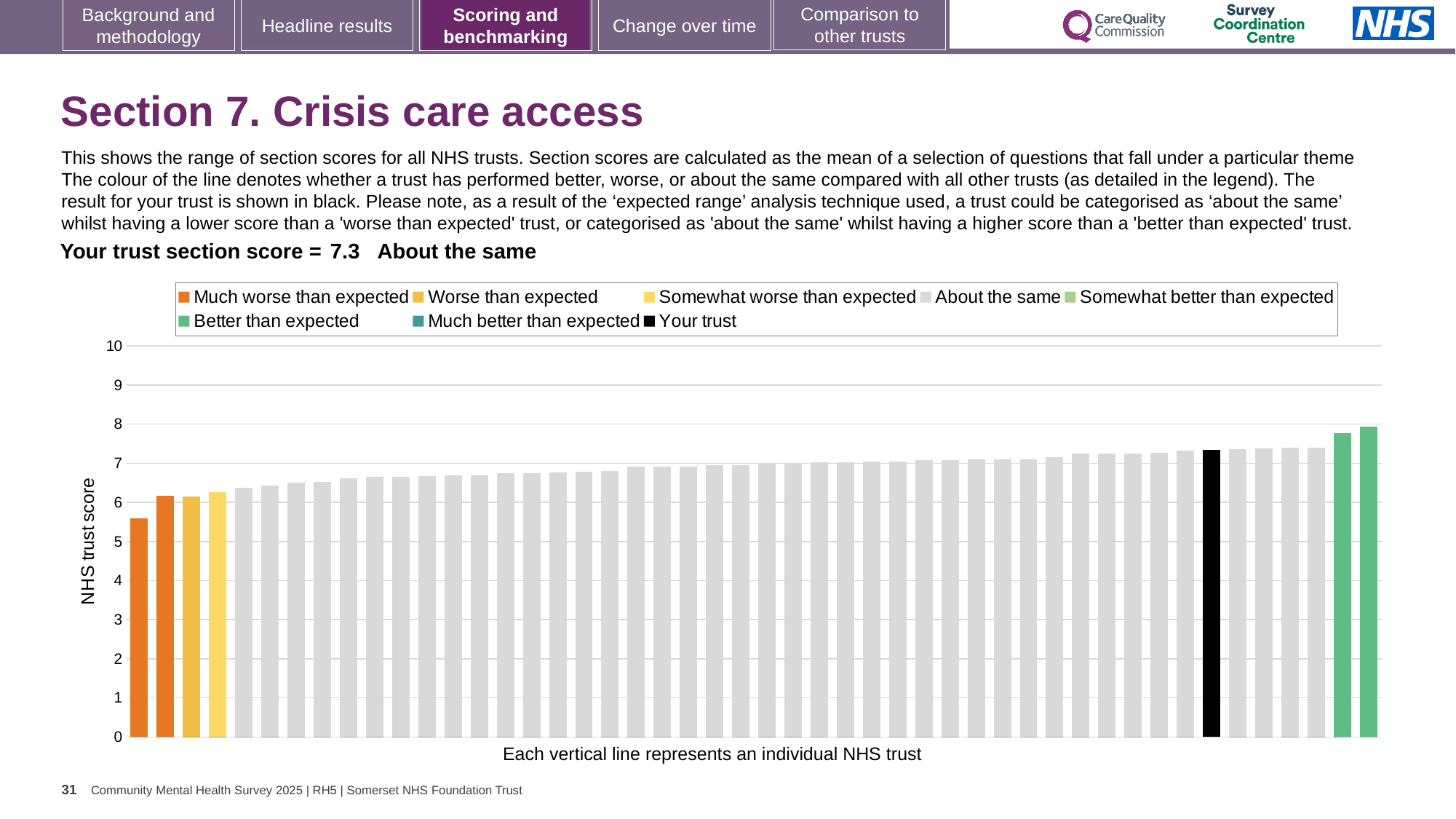
Which category is your trust placed in for this section? About the same Which legend category does the lowest bar in the chart belong to? Much worse than expected What is the label on the vertical axis of the chart? NHS trust score Is the black bar for your trust higher or lower than the rightmost green bar? Lower Is the value of the lowest bar in the chart greater or less than 6? less How many categories does the chart legend list? 8 Is the value for your trust (the black bar) greater or less than 7? greater What is the section score for your trust shown on the slide? 7.3 Is the value of the tallest bar in the chart greater or less than 7? greater What kind of chart is shown on the slide? Bar chart What colour is used in the chart to show your trust? Black Do the bar values rise or fall from left to right along the x axis? Rise